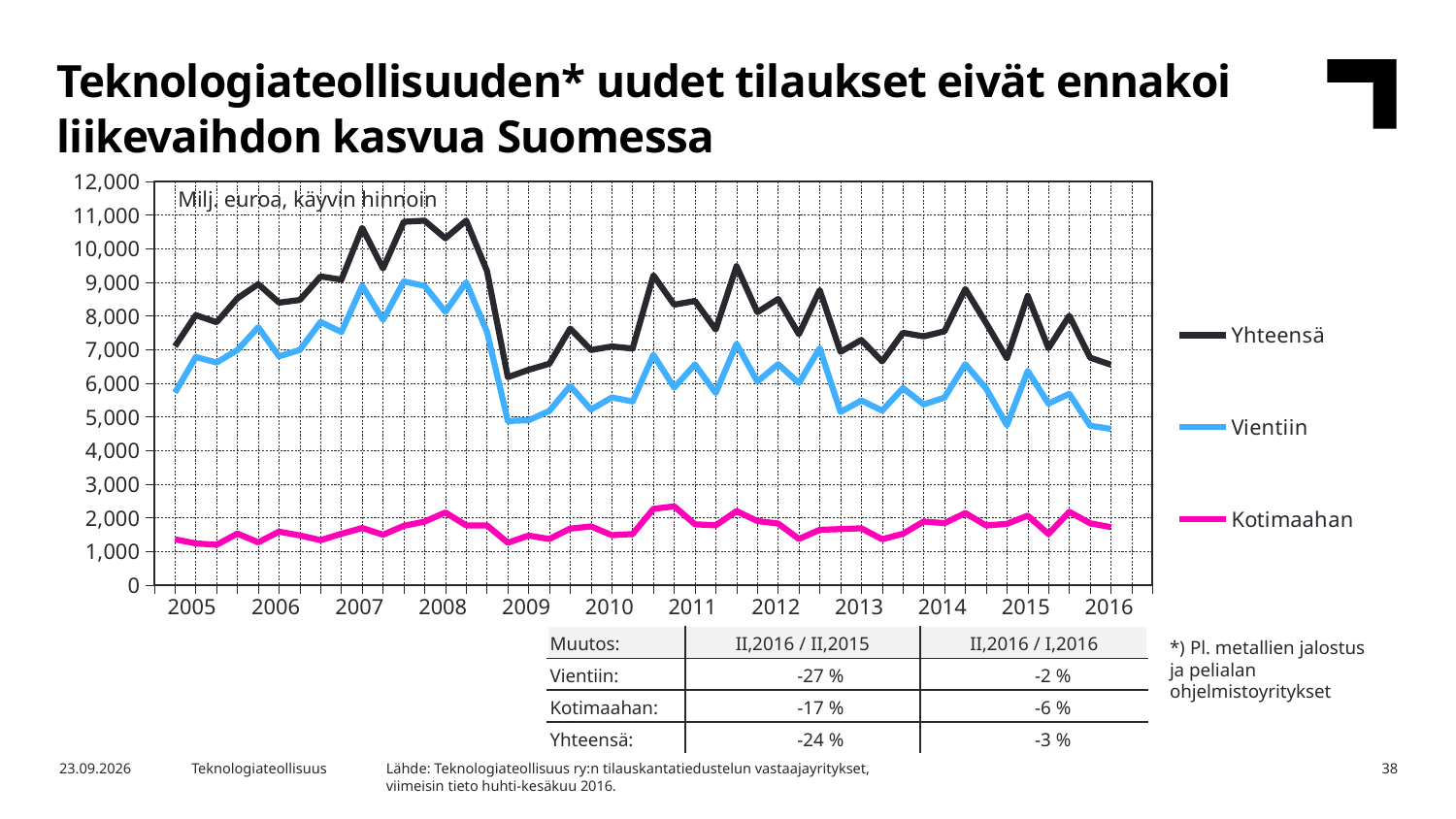
What type of chart is shown on the slide? line chart How many years are labelled on the x axis of the chart? 12 What unit label is printed inside the chart's plot area? Milj. euroa, käyvin hinnoin Which series has the highest values across the whole chart? Yhteensä Is the last plotted value for Vientiin in 2016 greater or less than 5,000? less Is the lowest value of Yhteensä in 2009 greater or less than 7,000? less Does the Yhteensä series rise or fall from 2015 to 2016? fall How many series does the chart's legend list? 3 What are the three series named in the chart's legend? Yhteensä, Vientiin, Kotimaahan Is the peak value of Yhteensä in 2008 greater or less than 10,000? greater Which series has the lowest values across the whole chart? Kotimaahan